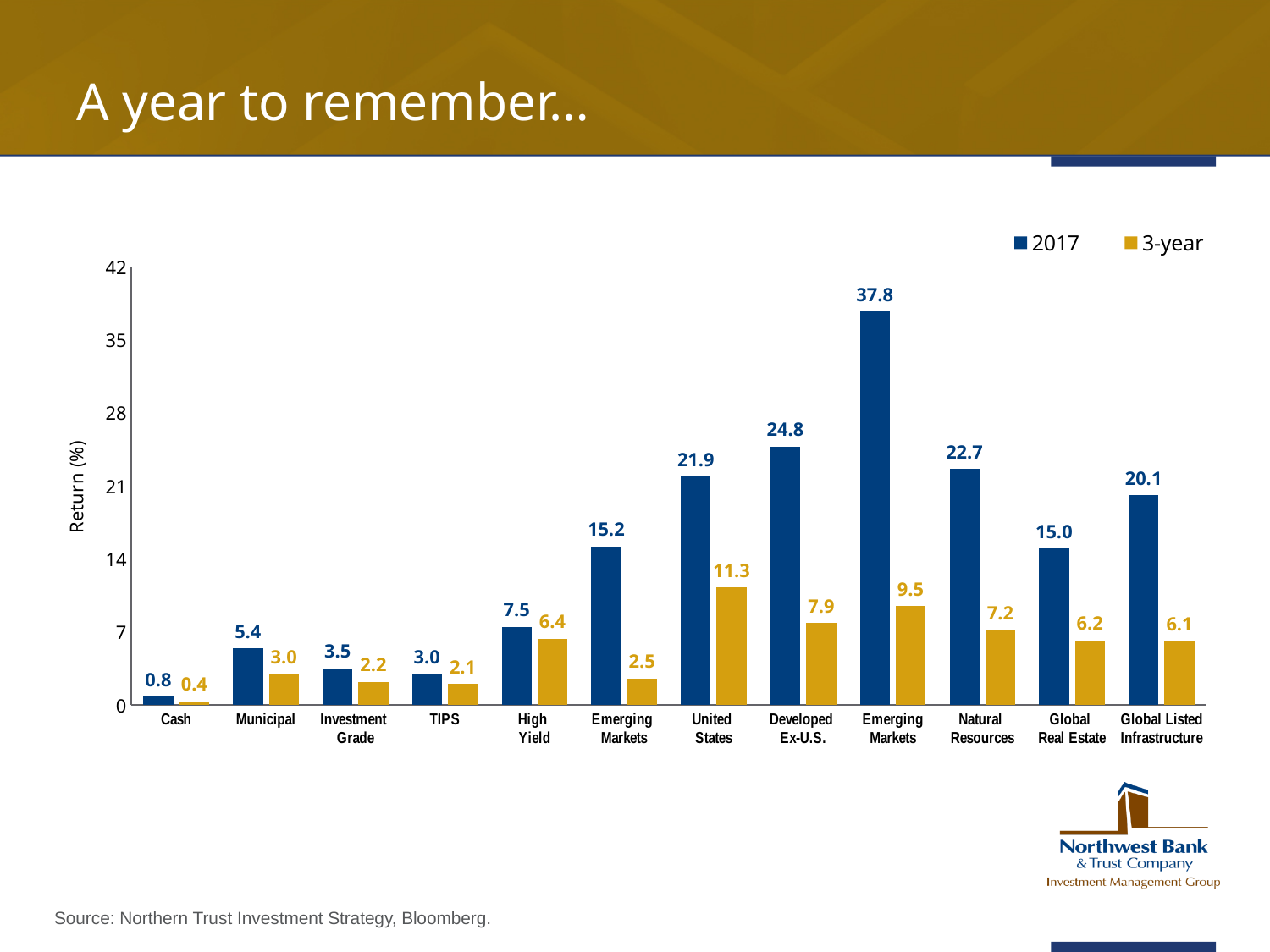
Which category has the highest 2017 return? Emerging Markets (the one between Developed Ex-U.S. and Natural Resources) What is the 3-year return for Cash? 0.4 What kind of chart is shown on the slide? Bar chart Which category has the lowest 3-year return? Cash What is the 2017 return for Developed Ex-U.S.? 24.8 What is the difference between the 2017 and 3-year returns for Natural Resources? 15.5 Which is larger: the 2017 return for United States or the 2017 return for Natural Resources? Natural Resources What is the 3-year return for United States? 11.3 What is the label of the y axis? Return (%) How many categories are shown on the x axis? 12 How many series does the legend list? 2 What is the 2017 return for Global Listed Infrastructure? 20.1